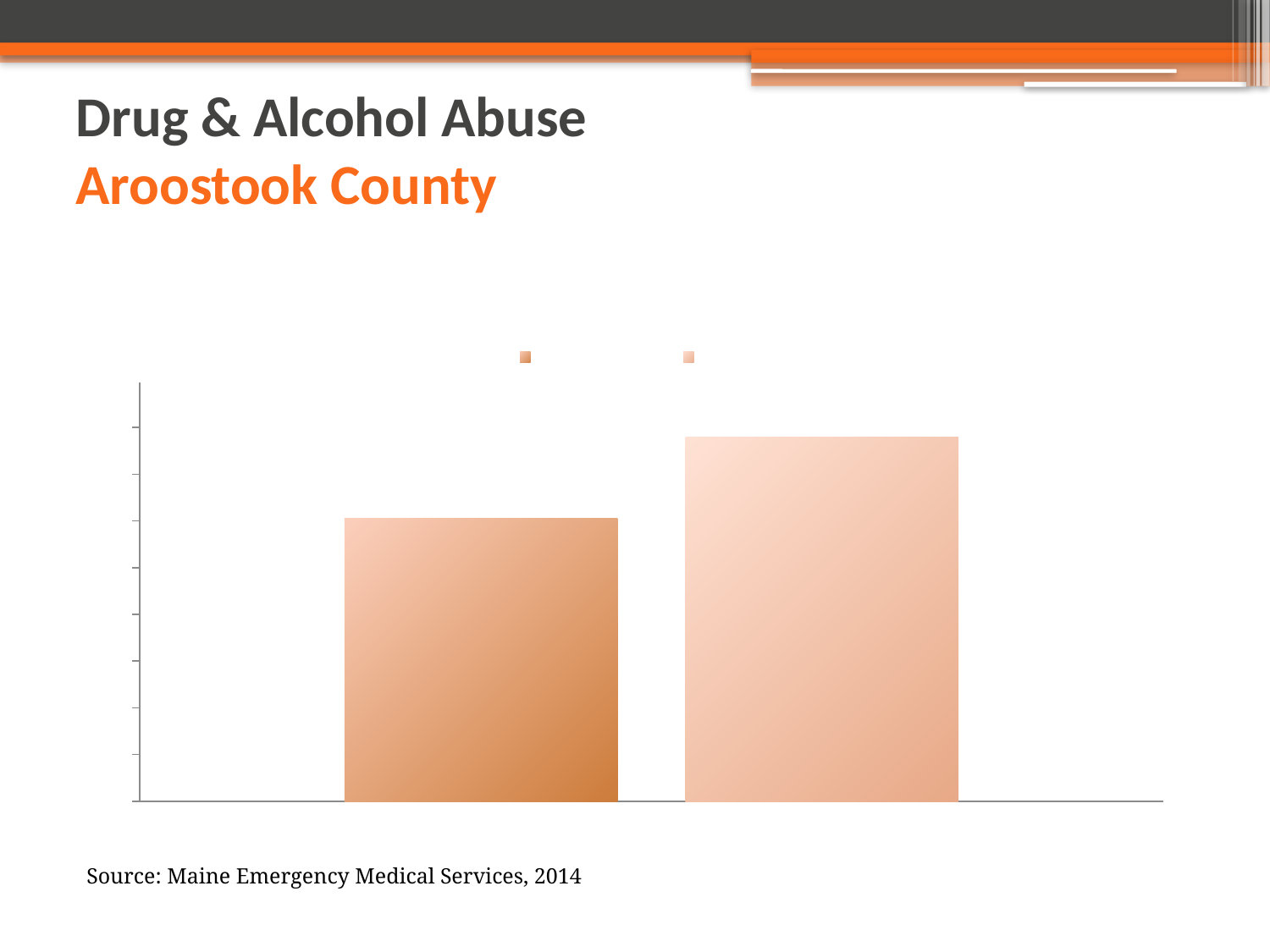
Which bar is taller, the left bar or the right bar? the right bar Which county does the slide title say the chart is about? Aroostook County How many entries does the chart's legend show? 2 What kind of chart is shown on the slide? bar chart What is the source cited below the chart? Maine Emergency Medical Services, 2014 Which bar is the tallest in the chart? the right bar How many bars are plotted in the chart? 2 Which bar is the shortest in the chart? the left bar